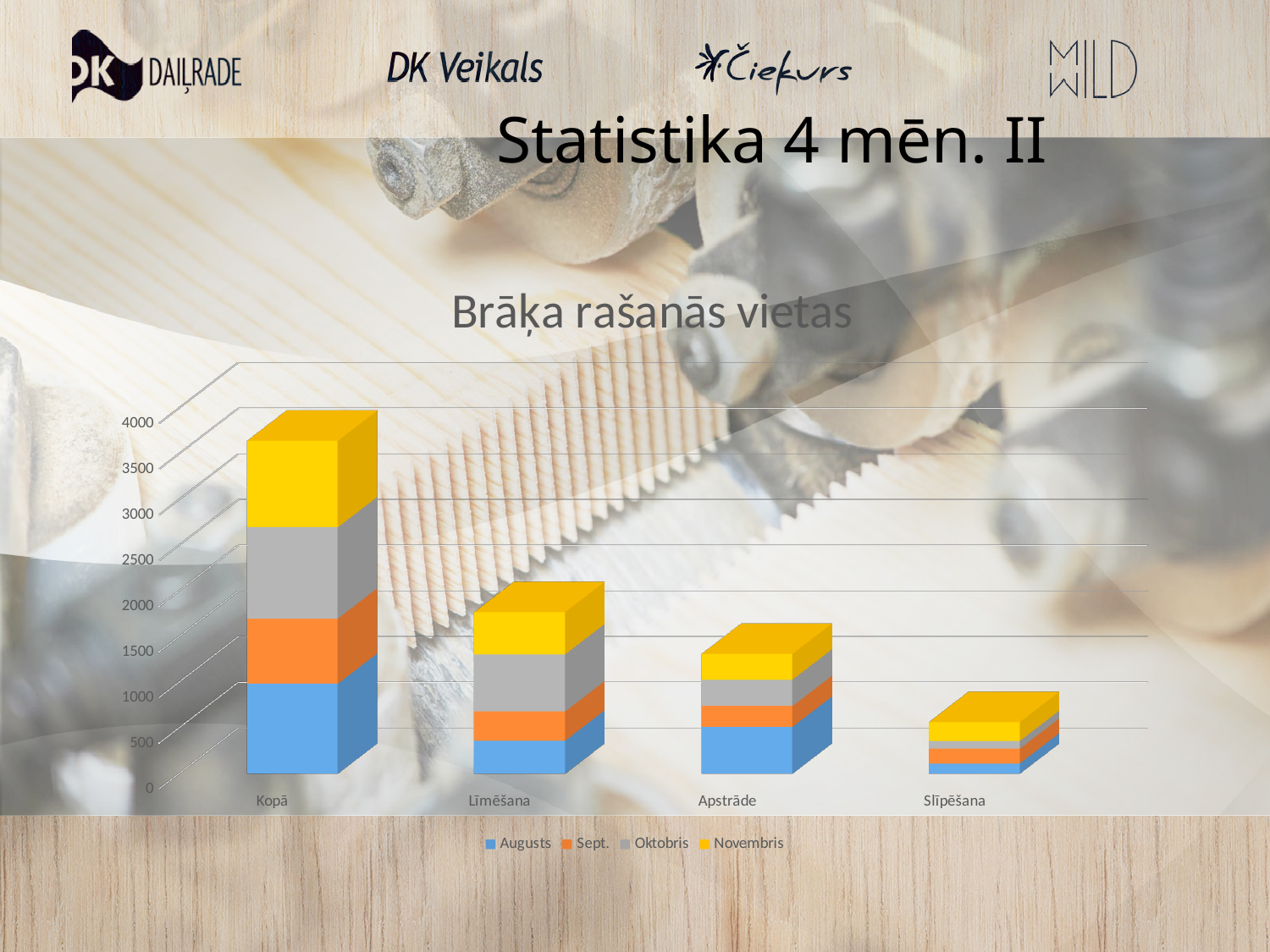
Is the total stacked bar for Apstrāde greater or less than 2000? less Is the total stacked bar for Slīpēšana greater or less than 1000? less Which stacked bar is taller, Apstrāde or Slīpēšana? Apstrāde What kind of chart is shown on the slide? Stacked bar chart How many categories are shown on the x axis of the chart? 4 Is the total stacked bar for Līmēšana greater or less than 1000? greater How many series does the chart legend list? 4 What is the title of the chart? Brāķa rašanās vietas Which category has the shortest stacked bar? Slīpēšana Which category has the tallest stacked bar? Kopā Which series are listed in the chart legend? Augusts, Sept., Oktobris, Novembris